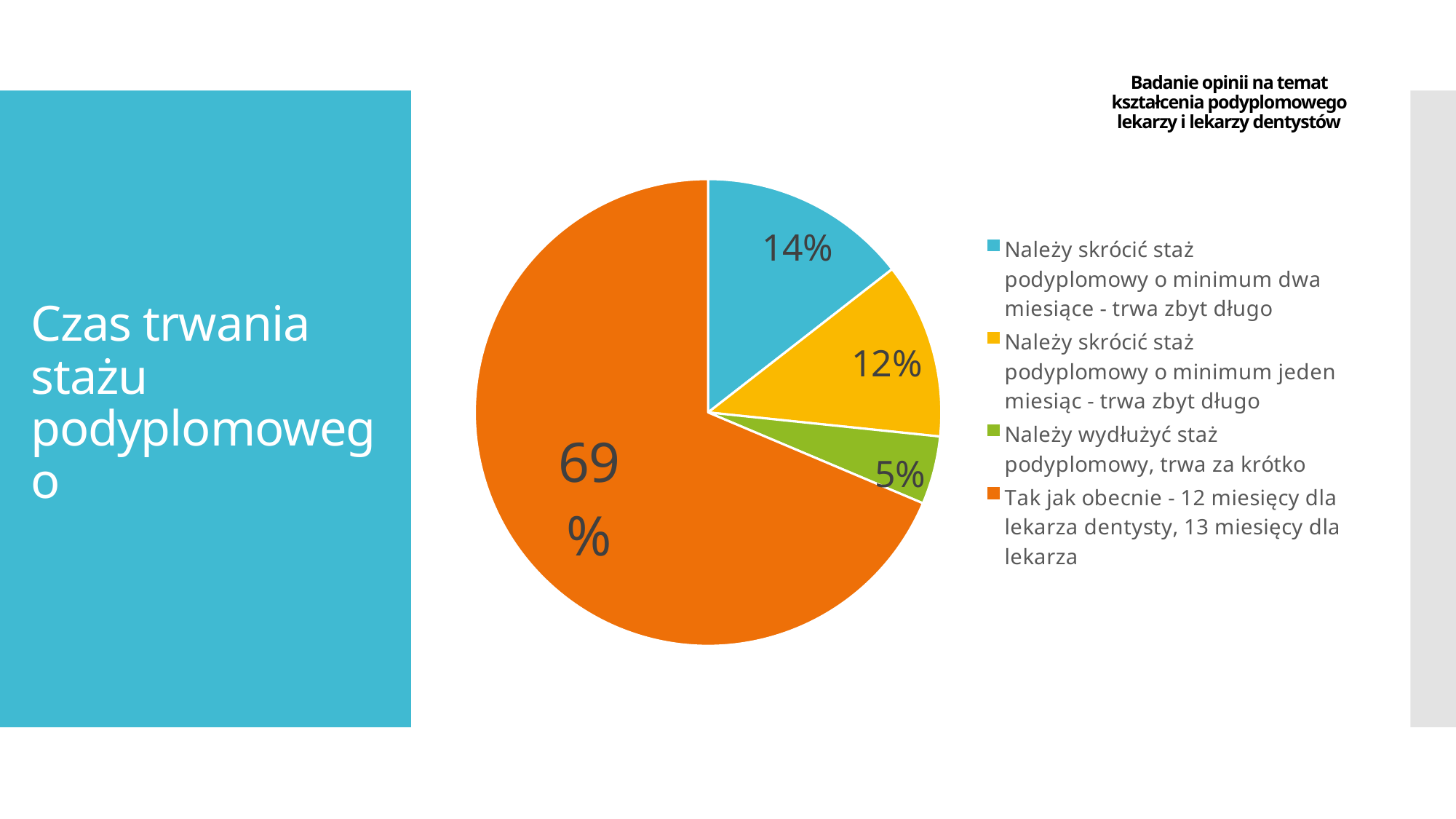
What share of the pie is labelled "Należy skrócić staż podyplomowy o minimum jeden miesiąc - trwa zbyt długo"? 12% How many entries does the legend list? 4 Which category has the largest slice of the pie? Tak jak obecnie - 12 miesięcy dla lekarza dentysty, 13 miesięcy dla lekarza What share of the pie is labelled "Tak jak obecnie - 12 miesięcy dla lekarza dentysty, 13 miesięcy dla lekarza"? 69% What is the difference in percentage points between the 69% slice and the 14% slice? 55 Which category has the smallest slice of the pie? Należy wydłużyć staż podyplomowy, trwa za krótko What colour is the slice labelled 5%? green What kind of chart is shown on the slide? pie chart What share of the pie is labelled "Należy skrócić staż podyplomowy o minimum dwa miesiące - trwa zbyt długo"? 14% What share of the pie is labelled "Należy wydłużyć staż podyplomowy, trwa za krótko"? 5% How many slices does the pie chart have? 4 Which is larger: the slice for shortening the internship by at least two months or the slice for shortening it by at least one month? shortening by at least two months (14%)